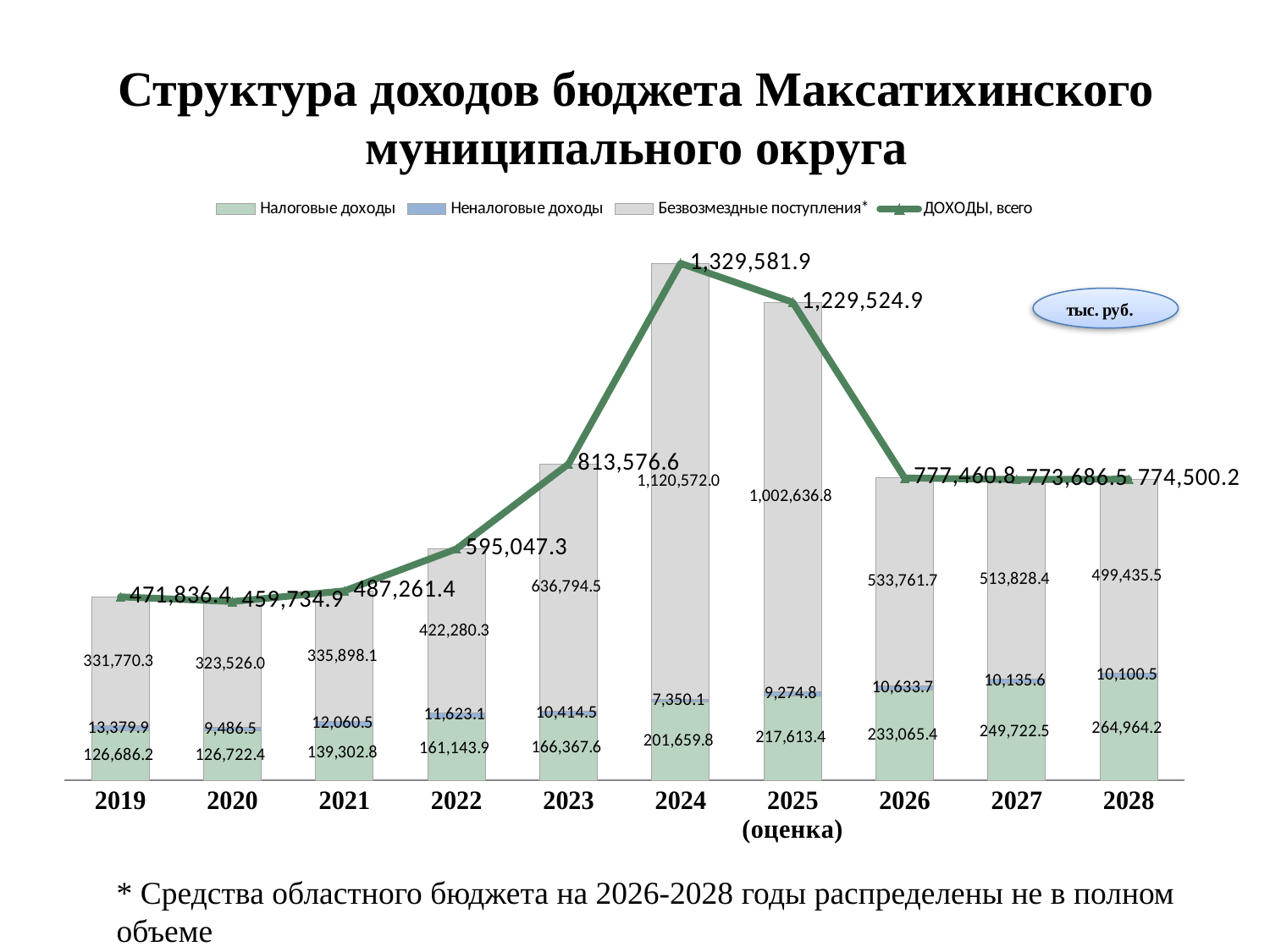
Which year has the larger value of Безвозмездные поступления, 2026 or 2027? 2026 What is the difference between ДОХОДЫ, всего in 2024 and in 2025? 100,057.0 What is the value of Налоговые доходы for 2028? 264,964.2 How many years are shown on the x axis? 10 What is the value of Неналоговые доходы for 2021? 12,060.5 What is the value of Безвозмездные поступления for 2023? 636,794.5 What kind of chart is shown on the slide? Stacked bar chart with a line Do the values of Налоговые доходы rise or fall from 2019 to 2028? Rise What is the value of ДОХОДЫ, всего for 2024? 1,329,581.9 How many series does the legend list? 4 In which year is ДОХОДЫ, всего the lowest? 2020 In which year is ДОХОДЫ, всего the highest? 2024